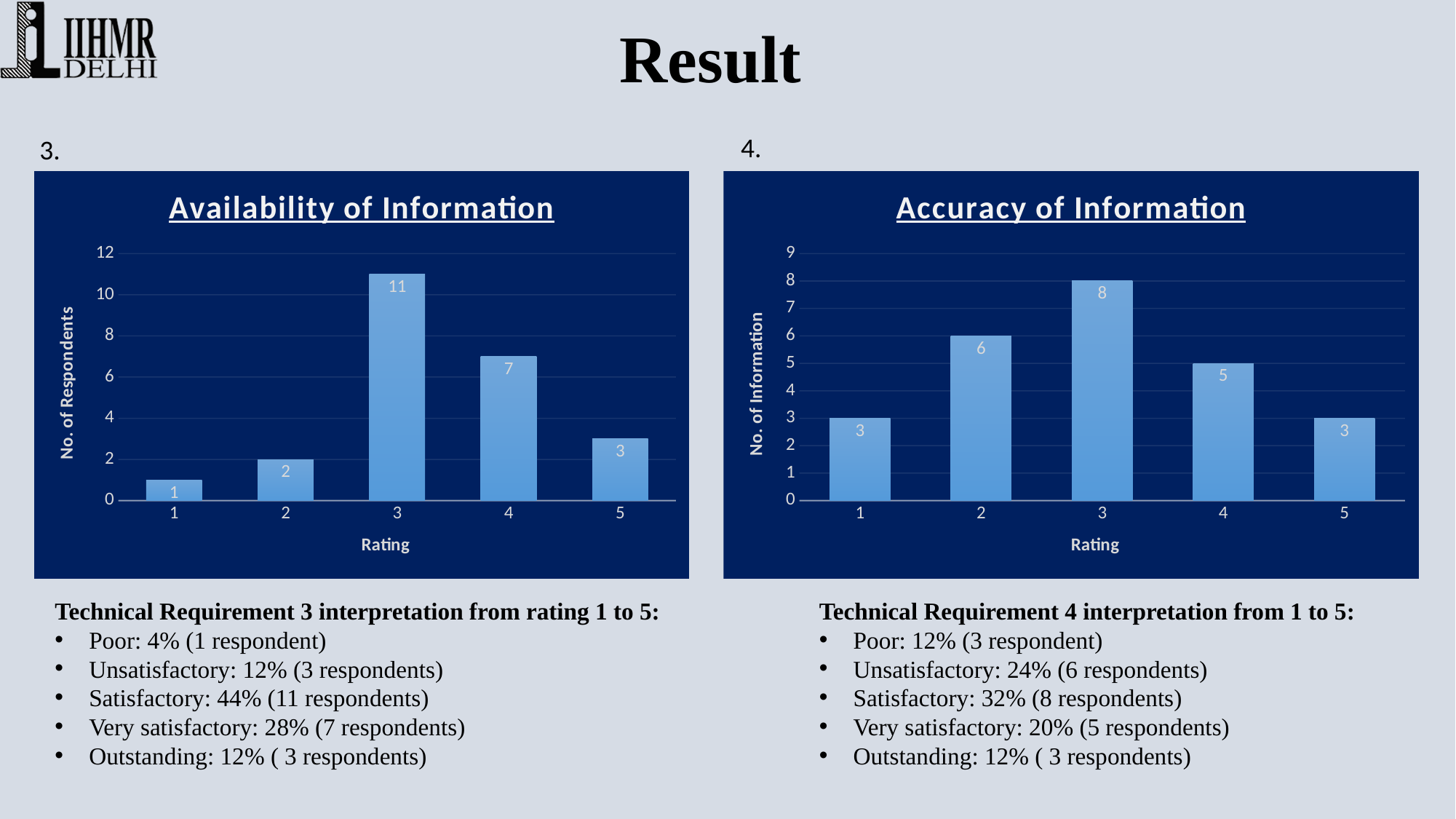
In the 'Availability of Information' chart, how many rating categories are shown on the x axis? 5 In the 'Availability of Information' chart, what is the difference between the values for rating 3 and rating 4? 4 In the 'Availability of Information' chart, how many respondents gave a rating of 3? 11 In the 'Accuracy of Information' chart, is the value for rating 3 greater or less than 7? greater In the 'Accuracy of Information' chart, what is the difference between the values for rating 3 and rating 5? 5 In the 'Availability of Information' chart, which rating has the lowest number of respondents? 1 What type of chart is the 'Accuracy of Information' chart? Bar chart In the 'Accuracy of Information' chart, which rating has the highest value? 3 In the 'Availability of Information' chart, what is the value for rating 4? 7 What is the y-axis label of the 'Availability of Information' chart? No. of Respondents In the 'Accuracy of Information' chart, which is larger, the value for rating 2 or the value for rating 4? Rating 2 In the 'Accuracy of Information' chart, what is the value for rating 2? 6